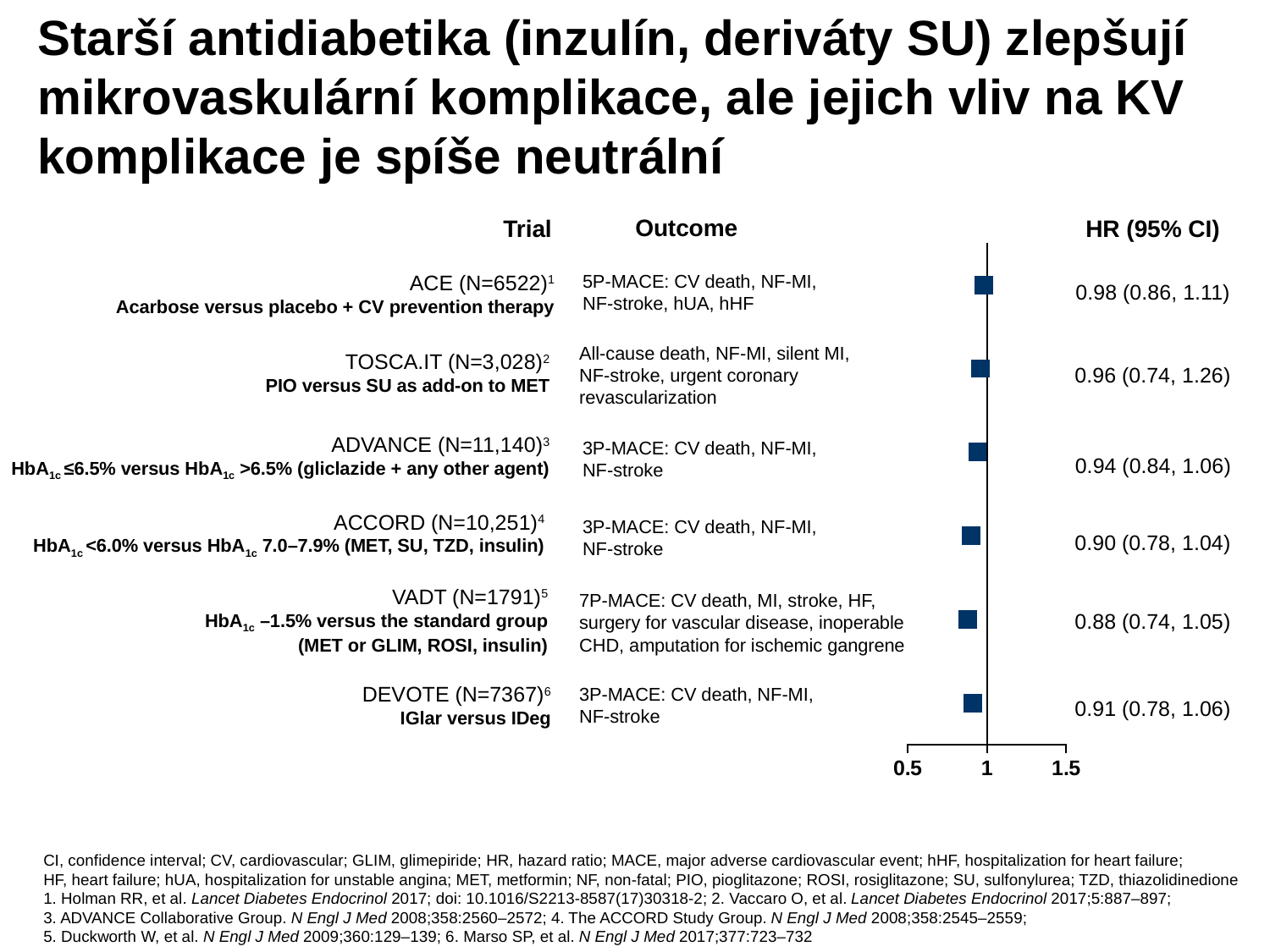
What is the upper limit of the 95% confidence interval for the TOSCA.IT trial? 1.26 Which trial has the highest hazard ratio on the plot? ACE What is the HR (95% CI) shown for the DEVOTE trial? 0.91 (0.78, 1.06) Which trial has the lowest hazard ratio on the plot? VADT What is the hazard ratio (HR) shown for the ACE trial? 0.98 What is the 95% confidence interval shown for the VADT trial? (0.74, 1.05) What is the difference between the hazard ratios of the ACE and VADT trials? 0.10 How many trials are plotted on the chart? 6 Is the hazard ratio for the ADVANCE trial greater or less than 1? less Which trial has the larger hazard ratio, TOSCA.IT or ACCORD? TOSCA.IT What is the hazard ratio shown for the ACCORD trial? 0.90 What kind of chart is shown on the slide? Forest plot